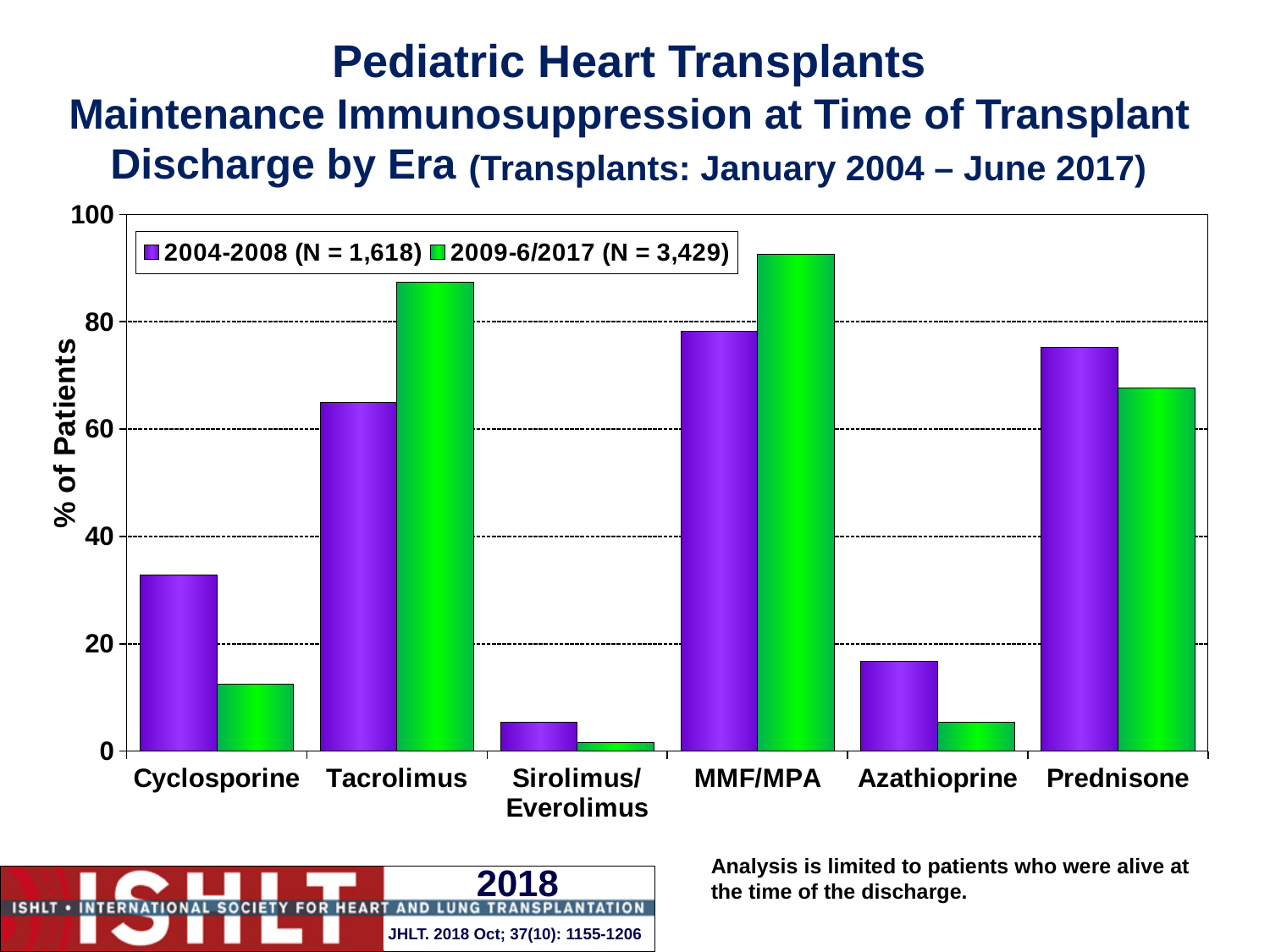
Is the value for Azathioprine in the 2004-2008 era greater or less than 20? less For Tacrolimus, which era has the larger value, 2004-2008 or 2009-6/2017? 2009-6/2017 How many series does the legend list? 2 Is the value for Tacrolimus in the 2009-6/2017 era greater or less than 80? greater What kind of chart is shown on the slide? bar chart Which drug has the highest value for the 2009-6/2017 era? MMF/MPA Is the value for Cyclosporine in the 2004-2008 era greater or less than 20? greater Which drug has the lowest value for the 2004-2008 era? Sirolimus/Everolimus For Prednisone, which era has the larger value, 2004-2008 or 2009-6/2017? 2004-2008 What is the label of the y axis? % of Patients Which drug has the lowest value for the 2009-6/2017 era? Sirolimus/Everolimus How many drug categories are shown on the x axis? 6